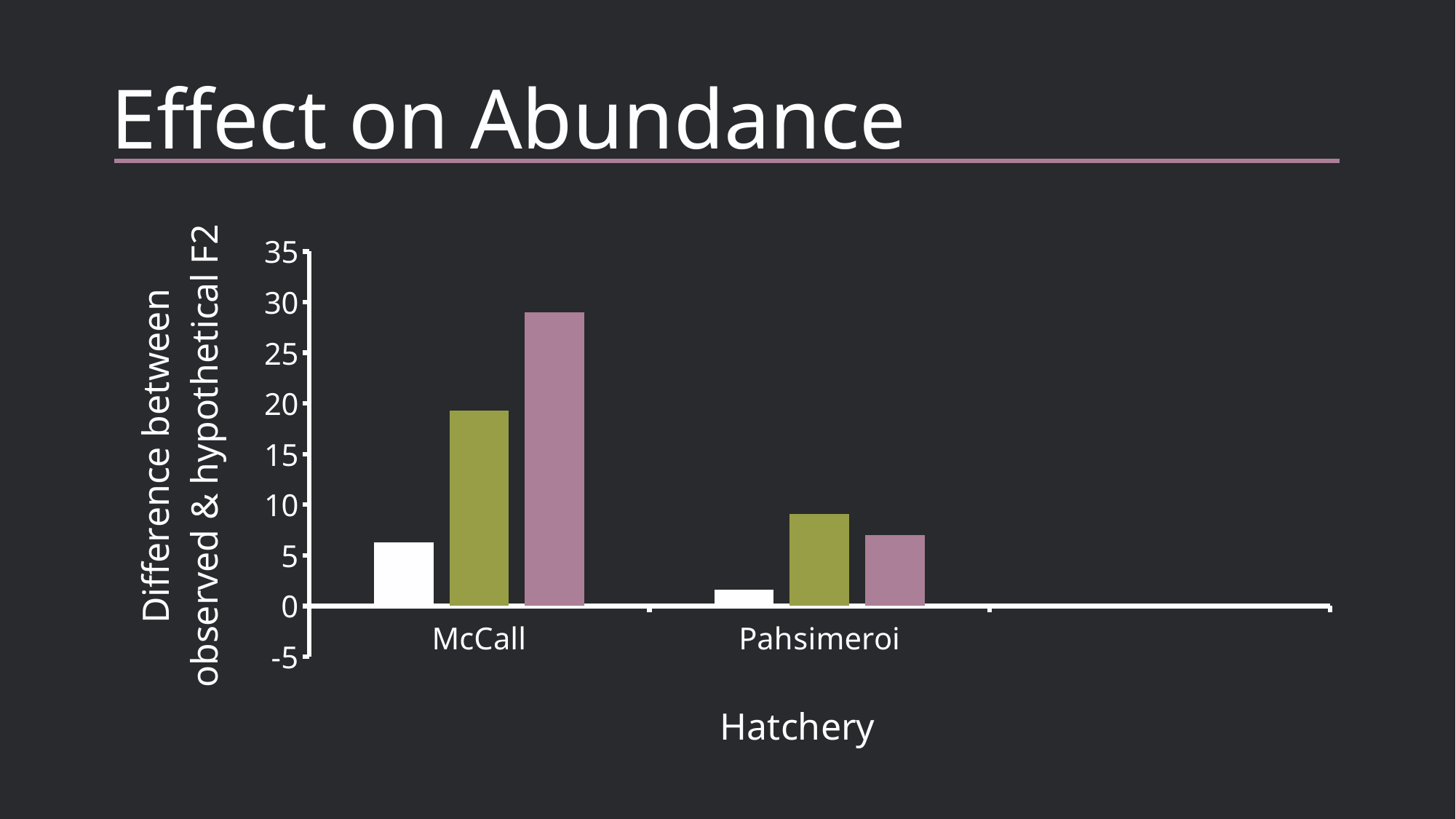
How many hatcheries (categories) are shown on the x axis? 2 What is the title of the chart? Effect on Abundance Is the value of the olive bar for McCall greater or less than 15? greater What is the title of the x axis? Hatchery For Pahsimeroi, which is larger, the olive bar or the pink bar? the olive bar Which is larger, the pink bar for McCall or the pink bar for Pahsimeroi? McCall What kind of chart is shown on the slide? bar chart Which hatchery has the tallest bar in the chart? McCall Is the value of the pink bar for McCall greater or less than 25? greater Is the value of the white bar for McCall greater or less than 10? less Which hatchery has the shortest bar in the chart? Pahsimeroi